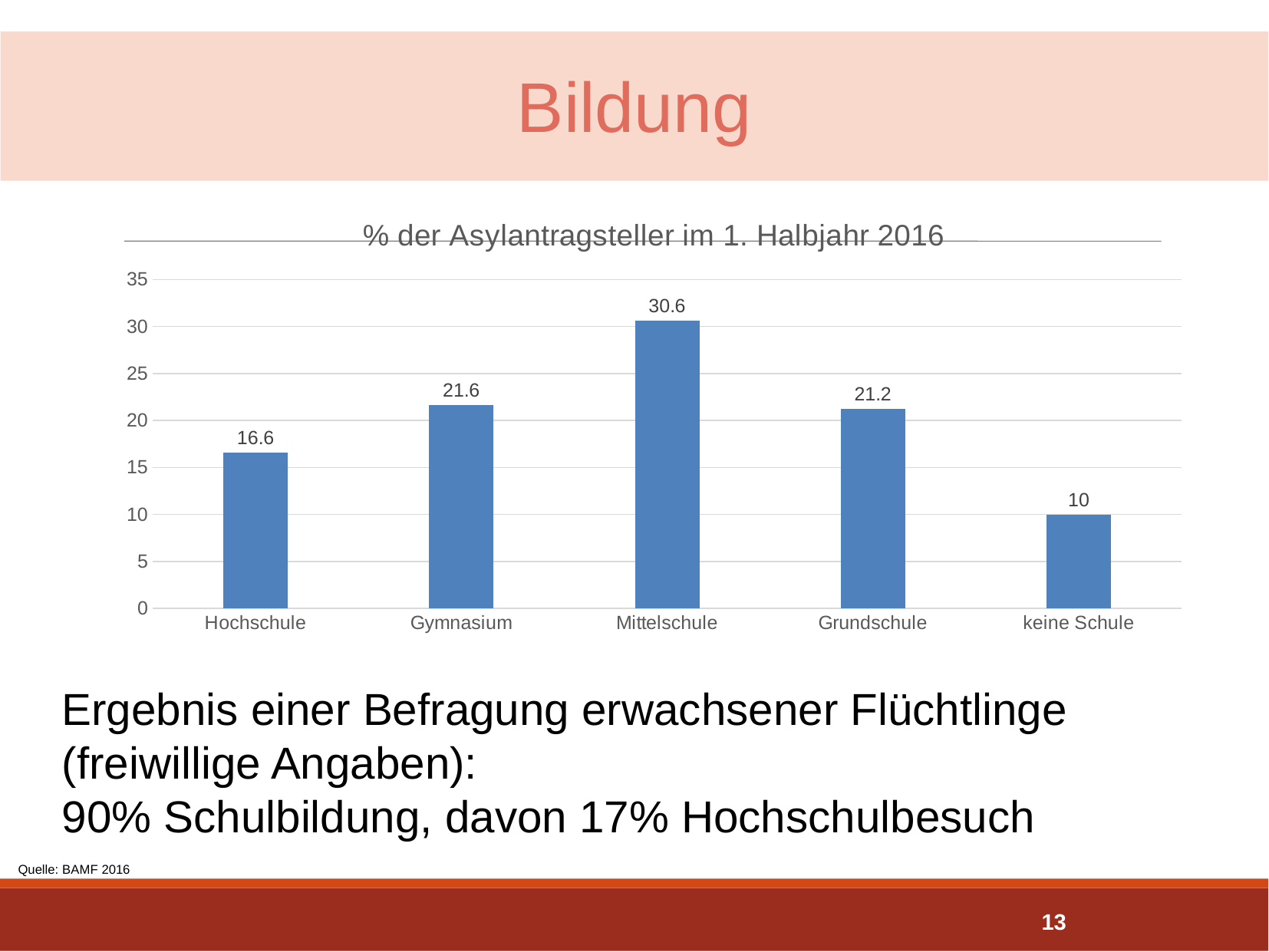
What is the difference between the values for Mittelschule and Grundschule? 9.4 What is the value for Hochschule? 16.6 Which category has the highest value? Mittelschule What is the value for Mittelschule? 30.6 Which is larger, the value for Hochschule or the value for keine Schule? Hochschule Is the value for Mittelschule greater or less than 25? greater What is the value for keine Schule? 10 What is the difference between the values for Gymnasium and Hochschule? 5 What is the title of the chart? % der Asylantragsteller im 1. Halbjahr 2016 How many categories are shown on the x axis? 5 Which category has the lowest value? keine Schule What kind of chart is shown on the slide? bar chart